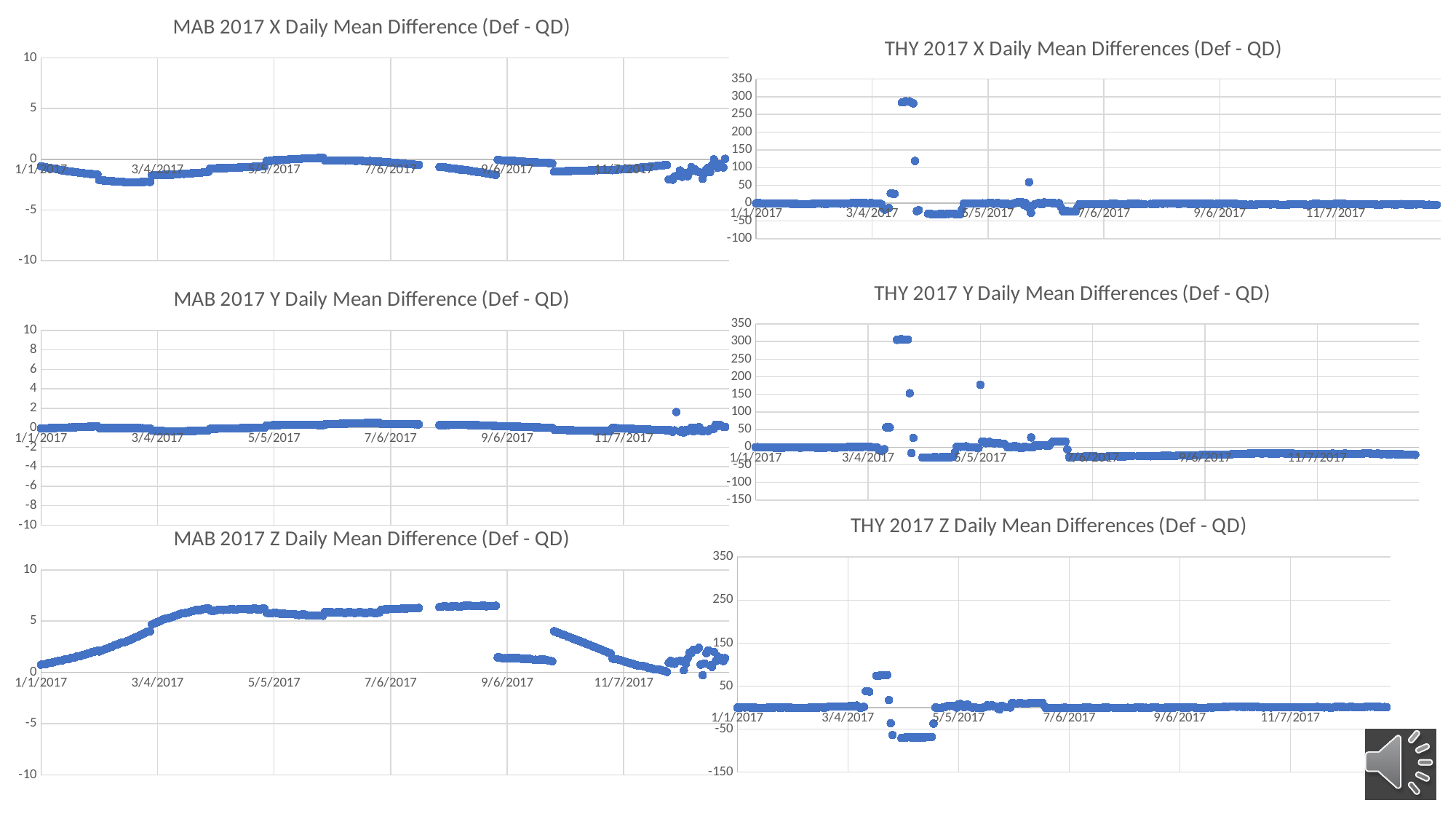
In the 'MAB 2017 Z Daily Mean Difference (Def - QD)' chart, which is larger: the value around 5/5/2017 or the value around 9/6/2017? 5/5/2017 In the 'THY 2017 X Daily Mean Differences (Def - QD)' chart, is the highest spike greater or less than 250? greater In the 'MAB 2017 X Daily Mean Difference (Def - QD)' chart, is the value at 5/5/2017 greater or less than 5? less In the 'THY 2017 Z Daily Mean Differences (Def - QD)' chart, are the lowest points greater or less than -50? less How many charts are shown on the slide? 6 What is the title of the top-left chart? MAB 2017 X Daily Mean Difference (Def - QD) What kind of chart is 'MAB 2017 X Daily Mean Difference (Def - QD)'? scatter chart In the 'MAB 2017 Z Daily Mean Difference (Def - QD)' chart, do the values rise or fall from 1/1/2017 to 3/4/2017? rise